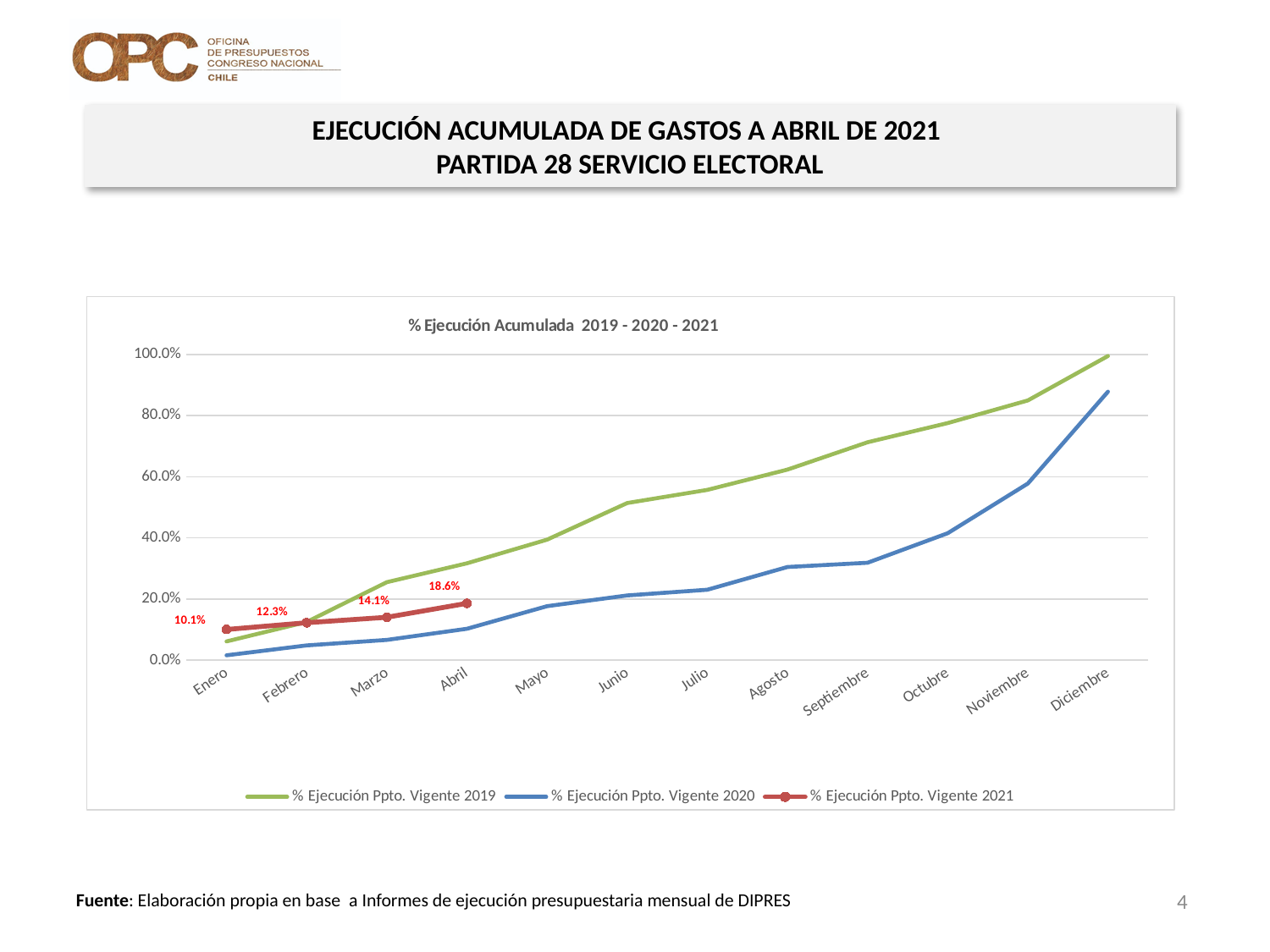
How many series does the legend list? 3 Among the labeled 2021 points, which month has the highest value? Abril In Diciembre, which series has the larger value: % Ejecución Ppto. Vigente 2019 or % Ejecución Ppto. Vigente 2020? % Ejecución Ppto. Vigente 2019 What is the value of % Ejecución Ppto. Vigente 2021 for Enero? 10.1% Is the value for % Ejecución Ppto. Vigente 2020 in Diciembre greater or less than 80.0%? greater By how many percentage points did % Ejecución Ppto. Vigente 2021 increase from Enero to Abril? 8.5 percentage points How many months are shown on the x axis? 12 What is the title of the chart? % Ejecución Acumulada 2019 - 2020 - 2021 What is the value of % Ejecución Ppto. Vigente 2021 for Abril? 18.6% What is the value of % Ejecución Ppto. Vigente 2021 for Marzo? 14.1% What kind of chart is shown on the slide? Line chart Does the % Ejecución Ppto. Vigente 2021 series rise or fall from Enero to Abril? Rise